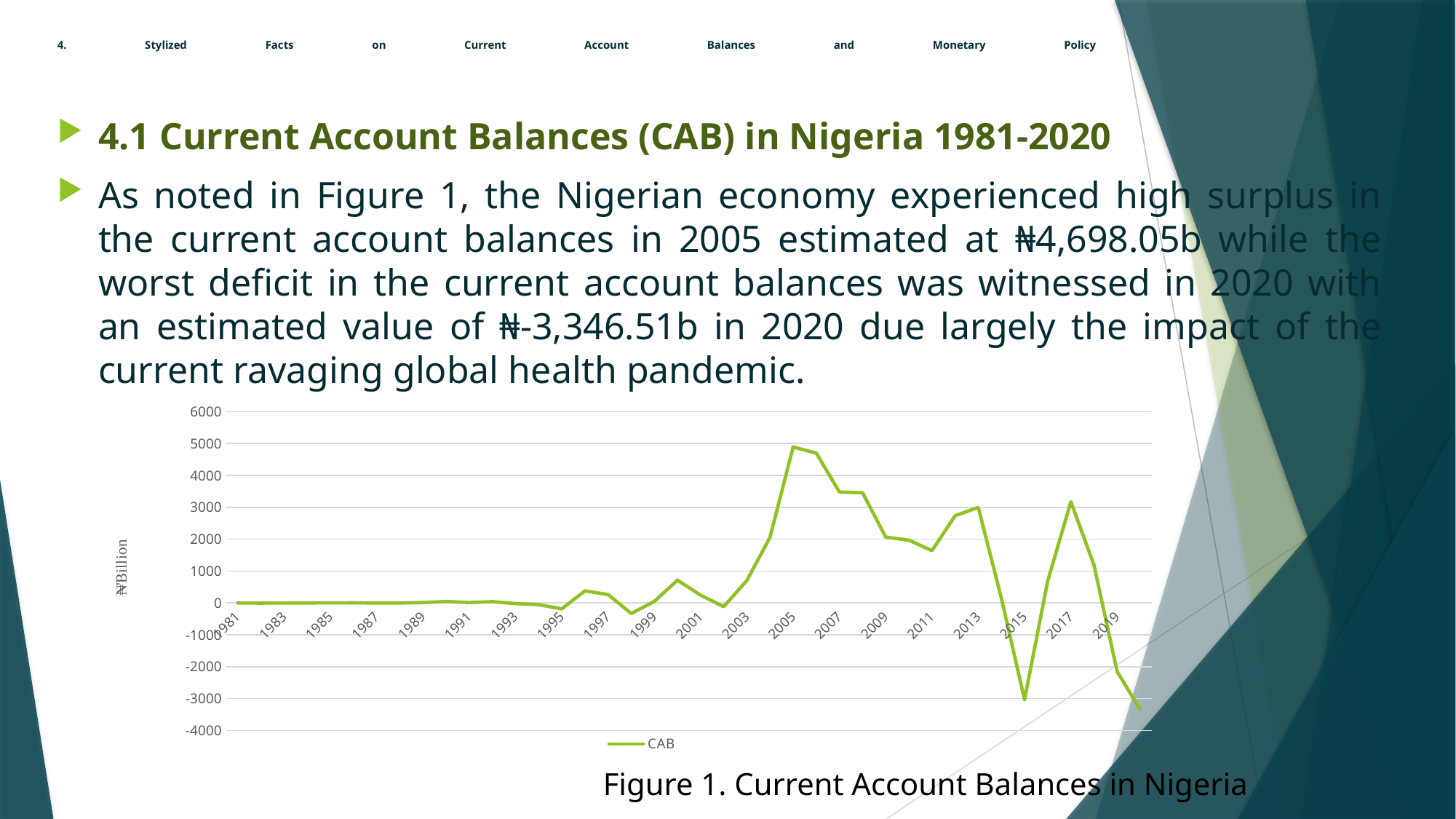
How many year labels are shown on the x axis of the chart? 20 Which year has the higher CAB value, 2005 or 2017? 2005 Is the CAB value for 2005 greater or less than 4000? greater Is the CAB value for 2001 greater or less than 1000? less What kind of chart is shown in Figure 1? line chart In which year does the CAB line reach its lowest value? 2020 How many series does the legend of the chart list? 1 What is the name of the series shown in the chart legend? CAB Does the CAB line rise or fall between 2005 and 2009? fall In which year does the CAB line reach its highest value? 2005 What is the caption of the chart on the slide? Figure 1. Current Account Balances in Nigeria Is the CAB value for 2015 greater or less than -2000? less